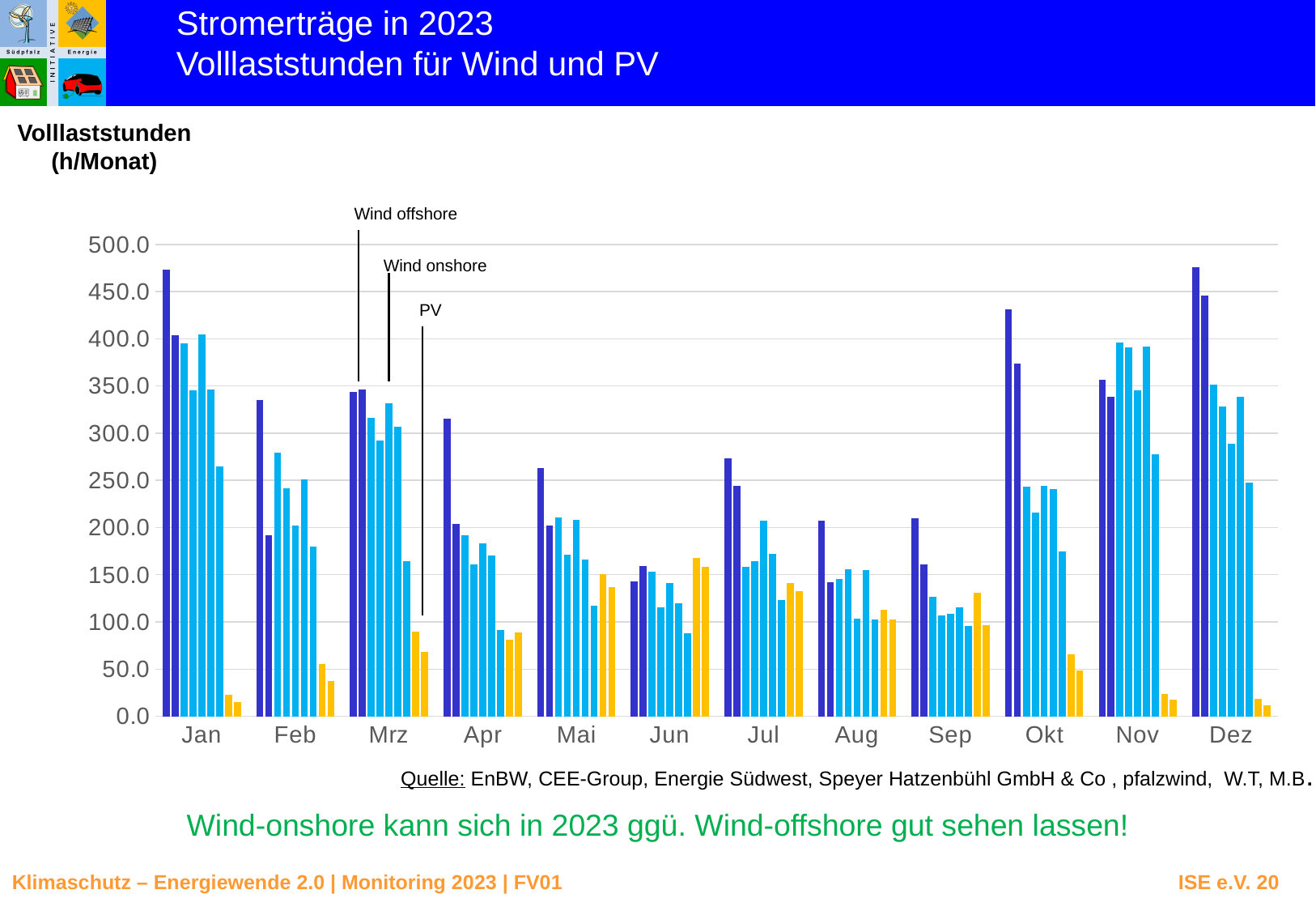
Do the PV values rise or fall from Jan to Jun? rise Are the PV values in Jun greater or less than 200? less Which three series are labelled in the chart? Wind offshore, Wind onshore, PV In which month are the PV values highest? Jun How many data series are labelled in the chart? 3 Is the highest Wind offshore value in Jul greater or less than 250? greater What kind of chart is shown on the slide? bar chart Is the highest Wind offshore value in Jan greater or less than 450? greater How many months are shown along the x axis of the chart? 12 What is the unit given for the y axis of the chart? h/Monat